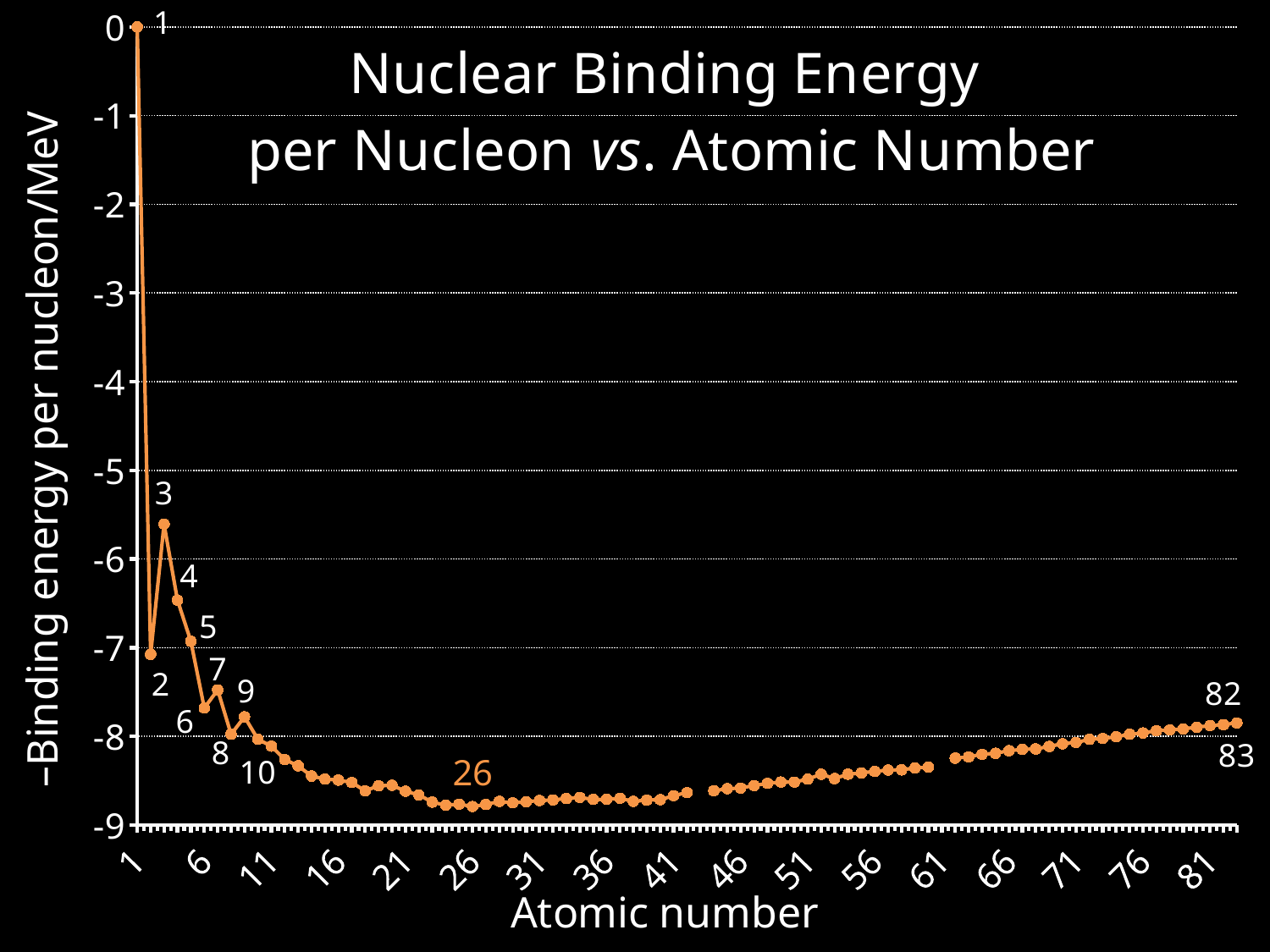
What is the title of the chart? Nuclear Binding Energy per Nucleon vs. Atomic Number What is the value plotted for atomic number 1? 0 Is the value for atomic number 26 greater or less than -8? less Which labelled atomic number marks the lowest point on the chart? 26 What type of chart is shown on the slide? line chart Is the value for atomic number 82 greater or less than -8? greater Which atomic number has the highest (least negative) value on the chart? 1 Which has the higher (less negative) value, atomic number 3 or atomic number 4? atomic number 3 From atomic number 26 to atomic number 83, do the plotted values rise or fall? rise Is the value for atomic number 2 greater or less than -7? less What is the label of the x axis? Atomic number